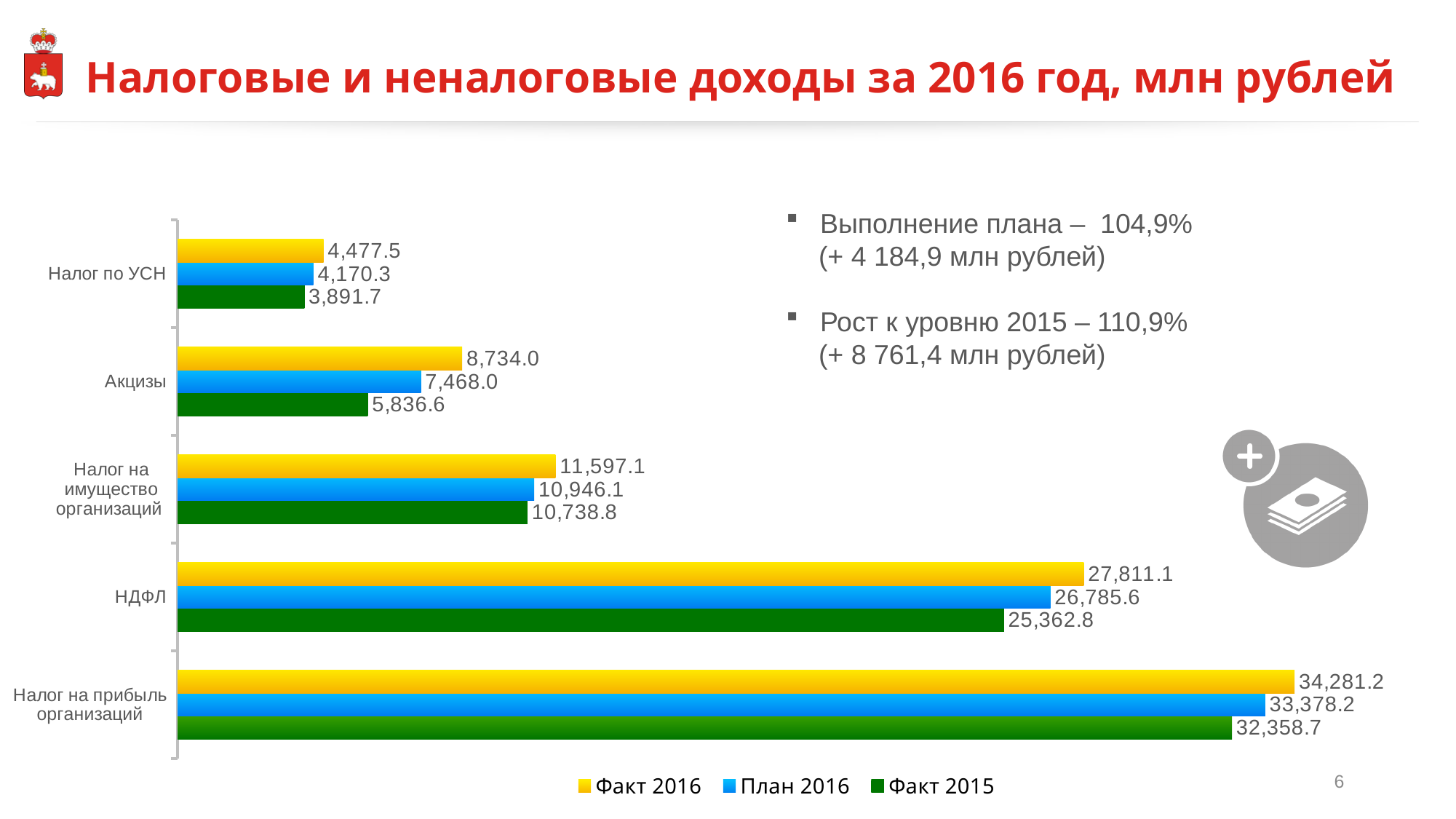
What is the Факт 2015 value for Акцизы? 5,836.6 What is the План 2016 value for НДФЛ? 26,785.6 Which category has the lowest Факт 2015 value? Налог по УСН What type of chart is shown on the slide? bar chart Which is larger for Налог на имущество организаций: Факт 2016 or Факт 2015? Факт 2016 How many series does the legend list? 3 What is the title of the chart slide? Налоговые и неналоговые доходы за 2016 год, млн рублей Which category has the highest Факт 2016 value? Налог на прибыль организаций What is the difference between Факт 2016 and План 2016 for Налог на прибыль организаций? 903.0 What is the Факт 2016 value for Налог по УСН? 4,477.5 How many categories are shown on the chart? 5 What is the Факт 2016 value for Налог на прибыль организаций? 34,281.2